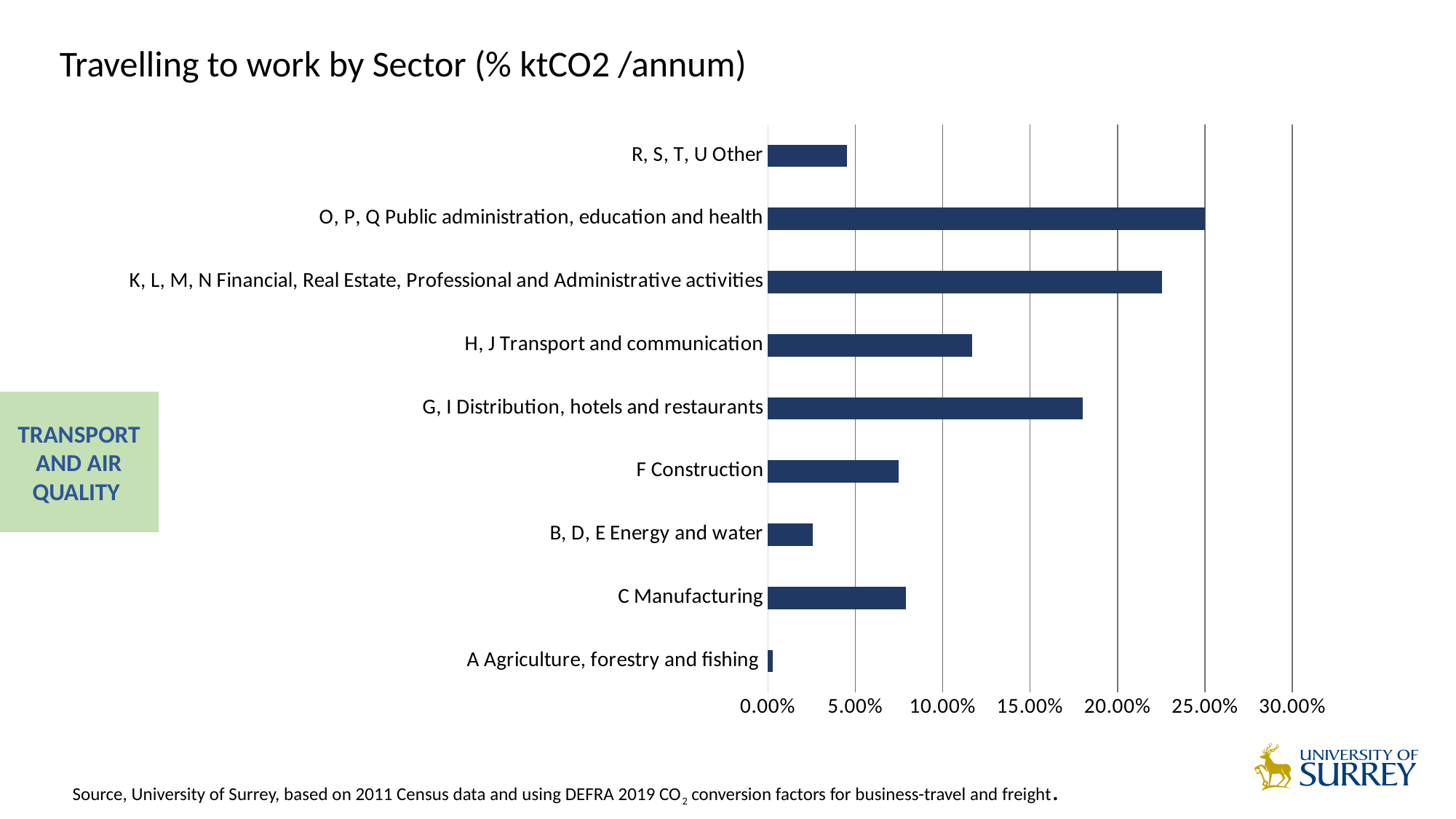
Is the value for O, P, Q Public administration, education and health greater or less than 20.00%? greater What kind of chart is shown on the slide? Bar chart Is the value for G, I Distribution, hotels and restaurants greater or less than 20.00%? less Which sector has the lowest value? A Agriculture, forestry and fishing Which is larger: the value for G, I Distribution, hotels and restaurants or the value for H, J Transport and communication? G, I Distribution, hotels and restaurants Is the value for H, J Transport and communication greater or less than 10.00%? greater What is the title of the chart? Travelling to work by Sector (% ktCO2 /annum) Which is larger: the value for K, L, M, N Financial, Real Estate, Professional and Administrative activities or the value for G, I Distribution, hotels and restaurants? K, L, M, N Financial, Real Estate, Professional and Administrative activities Which sector has the highest value? O, P, Q Public administration, education and health How many sector categories are plotted in the chart? 9